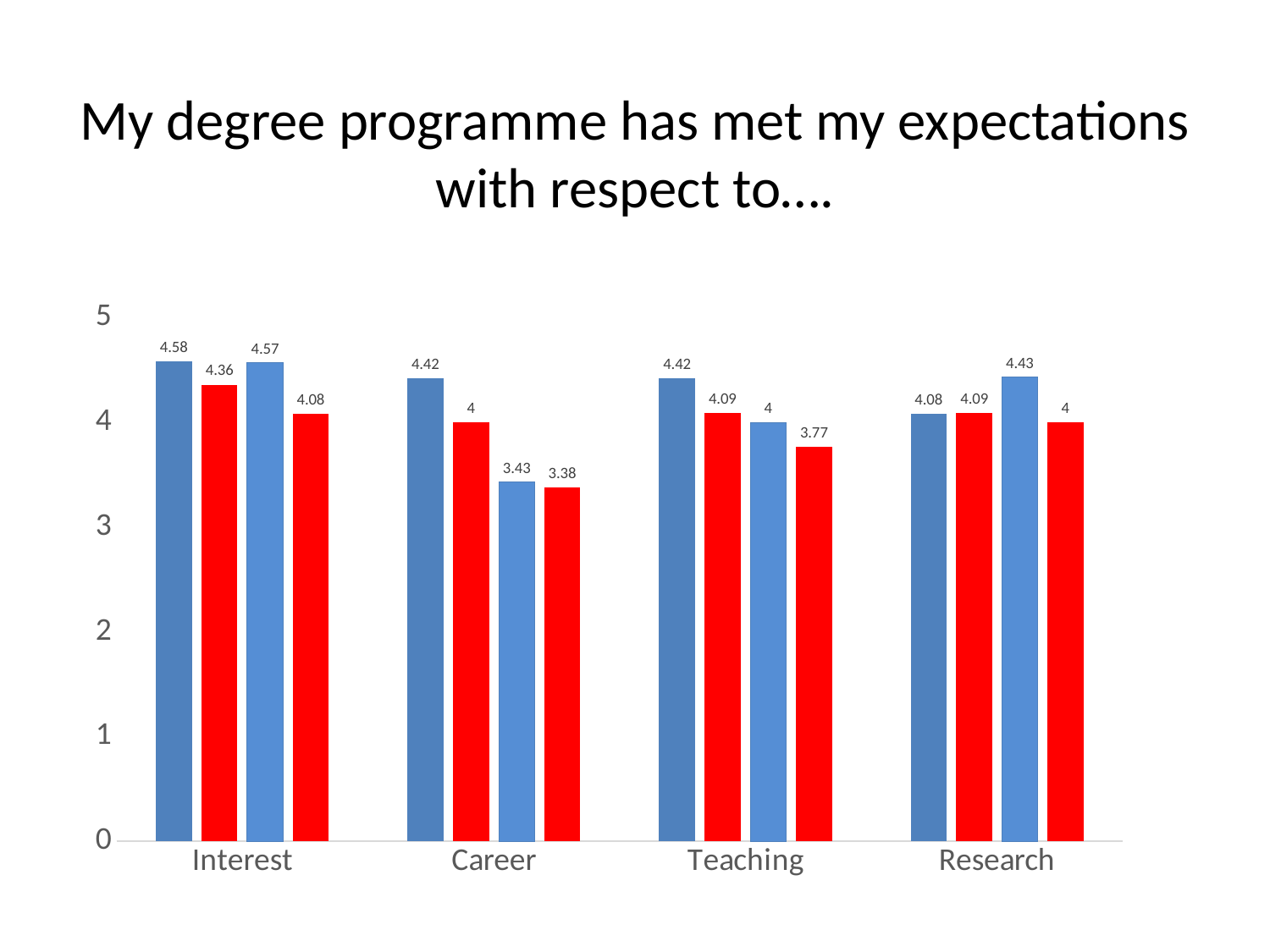
What is the title of the chart? My degree programme has met my expectations with respect to…. What is the difference between the first bar and the fourth bar for Interest? 0.5 Which is larger: the first bar for Career or the first bar for Research? Career What is the highest labelled value on the chart? 4.58 What is the value of the third bar for Research? 4.43 What is the value of the first (leftmost) bar for Interest? 4.58 How many categories are shown on the x axis? 4 What kind of chart is shown on the slide? bar chart Which category contains the lowest labelled value on the chart? Career What is the value of the fourth (rightmost) bar for Teaching? 3.77 What is the value of the third bar for Career? 3.43 How many bars are plotted for each category? 4